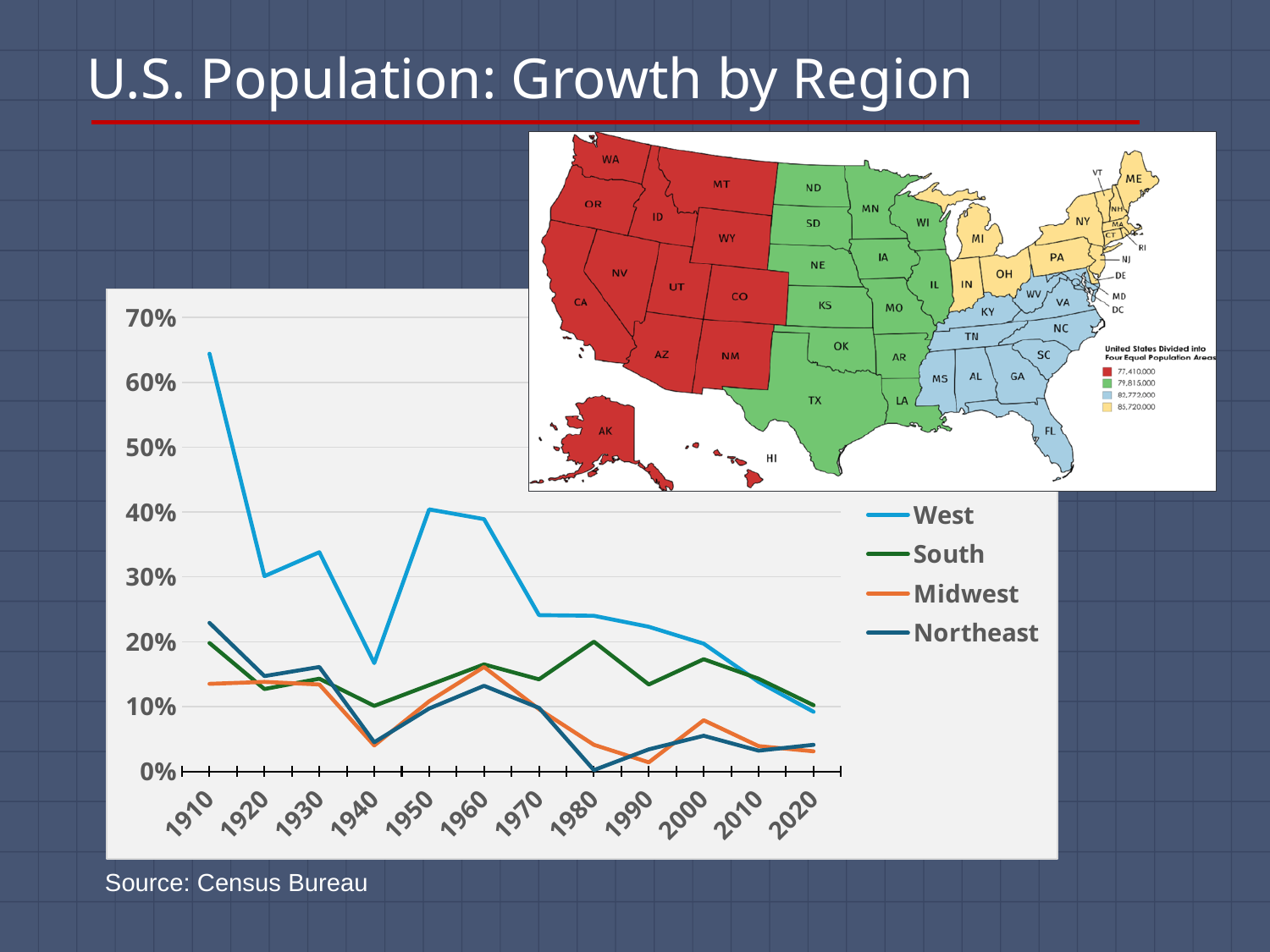
Which region had the lowest growth rate in 1980? Northeast Which region had the highest growth rate in 1910? West Is the value for West in 1910 greater or less than 60%? greater In 1980, which is larger, the value for South or the value for Midwest? South How many years are labelled along the x axis of the chart? 12 How many series does the chart's legend list? 4 Is the value for Midwest in 1990 greater or less than 10%? less Does the West line rise or fall from 1950 to 2020? fall Is the value for West in 1950 greater or less than 30%? greater What kind of chart is shown on the slide? line chart What source is cited for the chart's data? Census Bureau